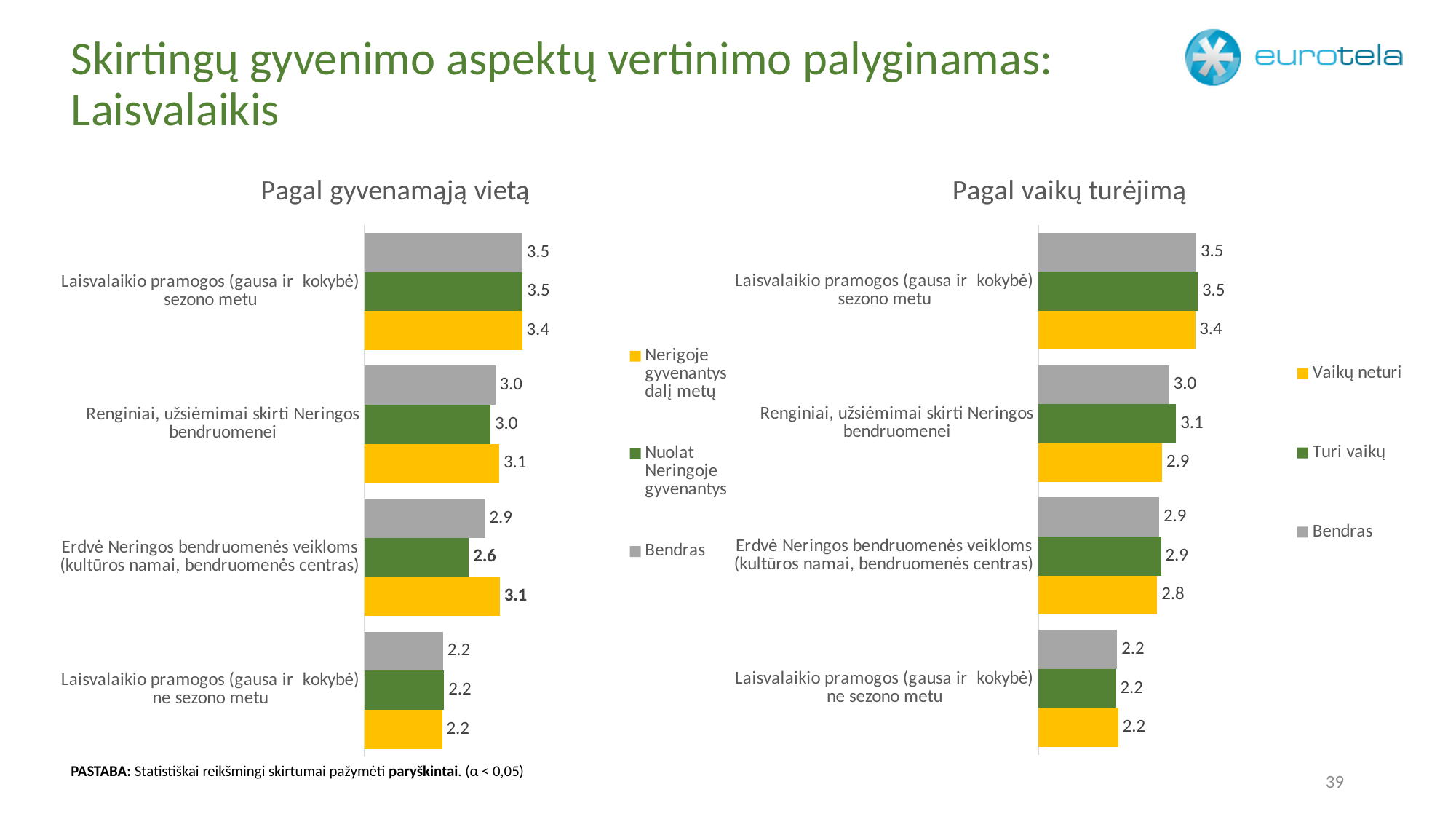
How many categories are shown in the chart 'Pagal gyvenamąją vietą'? 4 In the chart 'Pagal vaikų turėjimą', which category has the highest 'Vaikų neturi' value? Laisvalaikio pramogos (gausa ir kokybė) sezono metu In the chart 'Pagal gyvenamąją vietą', what is the difference between the 'Nerigoje gyvenantys dalį metų' and 'Nuolat Neringoje gyvenantys' values for 'Erdvė Neringos bendruomenės veikloms (kultūros namai, bendruomenės centras)'? 0.5 What type of chart is 'Pagal gyvenamąją vietą'? Bar chart In the chart 'Pagal vaikų turėjimą', which colour represents the 'Bendras' series? Gray In the chart 'Pagal gyvenamąją vietą', which category has the lowest 'Bendras' value? Laisvalaikio pramogos (gausa ir kokybė) ne sezono metu In the chart 'Pagal vaikų turėjimą', what is the value for 'Turi vaikų' for 'Renginiai, užsiėmimai skirti Neringos bendruomenei'? 3.1 In the chart 'Pagal vaikų turėjimą', what is the value for 'Vaikų neturi' for 'Erdvė Neringos bendruomenės veikloms (kultūros namai, bendruomenės centras)'? 2.8 How many series does the legend of the chart 'Pagal vaikų turėjimą' list? 3 In the chart 'Pagal gyvenamąją vietą', what is the value for 'Nerigoje gyvenantys dalį metų' for 'Laisvalaikio pramogos (gausa ir kokybė) sezono metu'? 3.4 In the chart 'Pagal vaikų turėjimą', which is larger for 'Renginiai, užsiėmimai skirti Neringos bendruomenei': 'Turi vaikų' or 'Vaikų neturi'? Turi vaikų In the chart 'Pagal gyvenamąją vietą', what is the value for 'Nuolat Neringoje gyvenantys' for 'Erdvė Neringos bendruomenės veikloms (kultūros namai, bendruomenės centras)'? 2.6